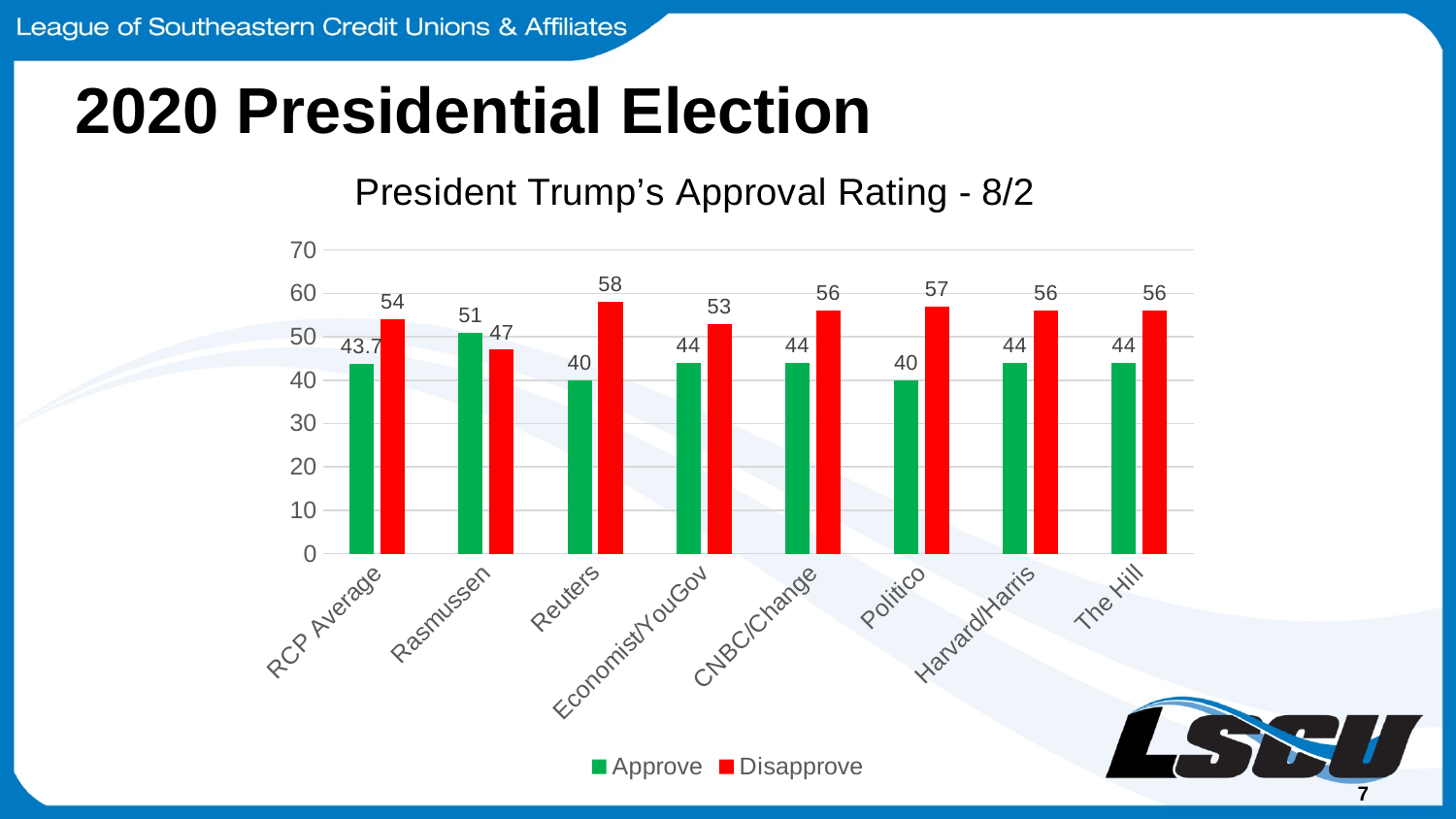
What is the Approve value for Rasmussen? 51 What kind of chart is shown on the slide? Bar chart How many pollsters are shown on the x axis? 8 What colour represents the Disapprove series? Red For Rasmussen, which is larger, Approve or Disapprove? Approve Which pollster has the highest Approve value? Rasmussen Which pollster has the highest Disapprove value? Reuters How many series does the legend list? 2 What is the difference between the Disapprove and Approve values for Politico? 17 Which pollster has the lowest Disapprove value? Rasmussen What is the Disapprove value for Reuters? 58 What is the Approve value for RCP Average? 43.7